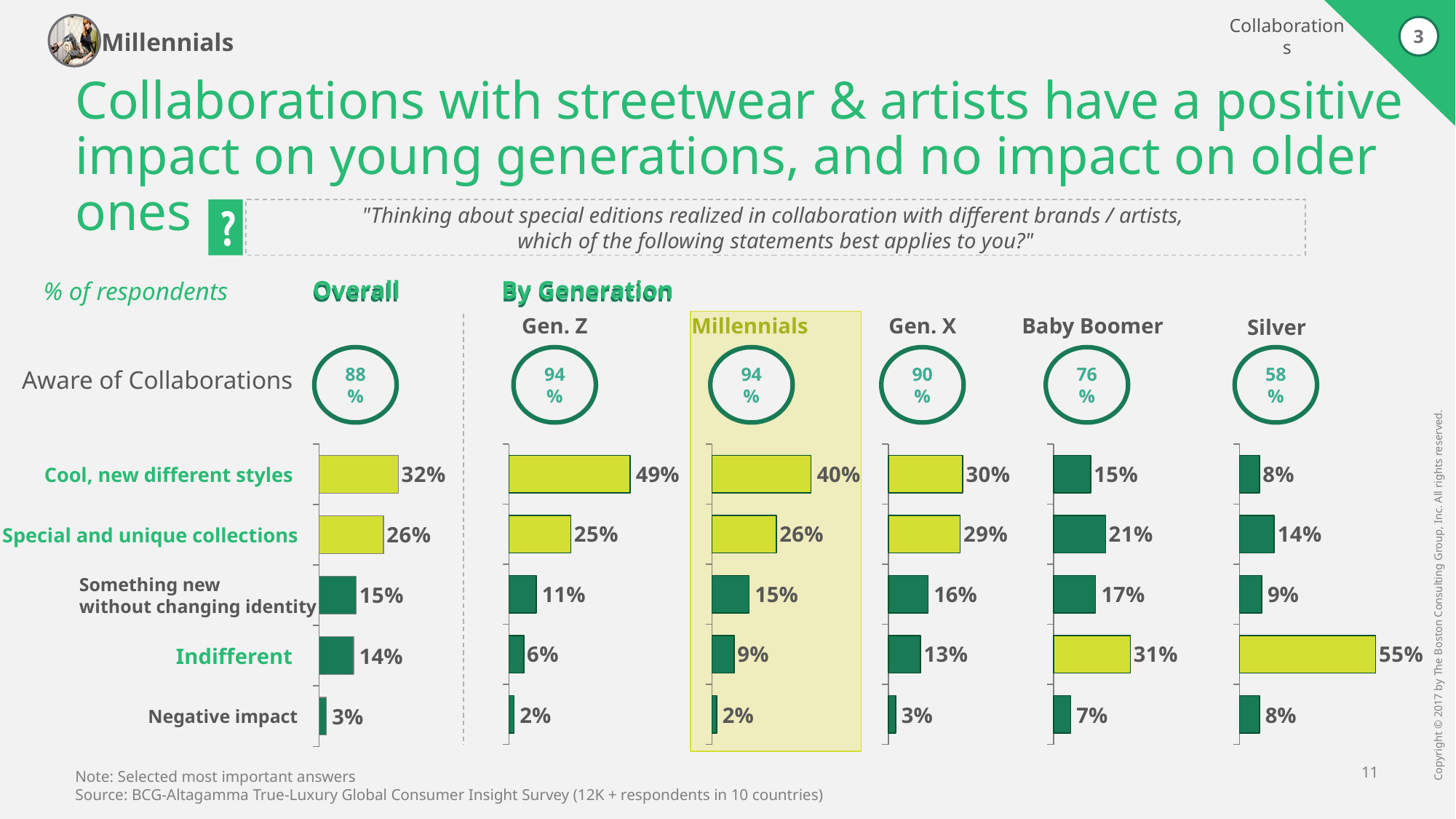
In the Overall chart, what percentage of respondents chose "Cool, new different styles"? 32% In the Millennials chart, which category has the lowest value? Negative impact In the Baby Boomer chart, which category has the highest value? Indifferent How many generation groups are shown in the "By Generation" section? 5 In the Gen. Z chart, what is the difference between "Indifferent" and "Negative impact"? 4% What percentage of Silver respondents are aware of collaborations? 58% How many categories are shown in the Overall bar chart? 5 In the Gen. X chart, what is the difference between "Cool, new different styles" and "Special and unique collections"? 1% Which is larger in the Baby Boomer chart: "Special and unique collections" or "Something new without changing identity"? Special and unique collections In the Gen. Z chart, what is the value for "Cool, new different styles"? 49% What kind of chart is used to show the responses for each generation? Bar chart In the Silver chart, what is the value for "Indifferent"? 55%